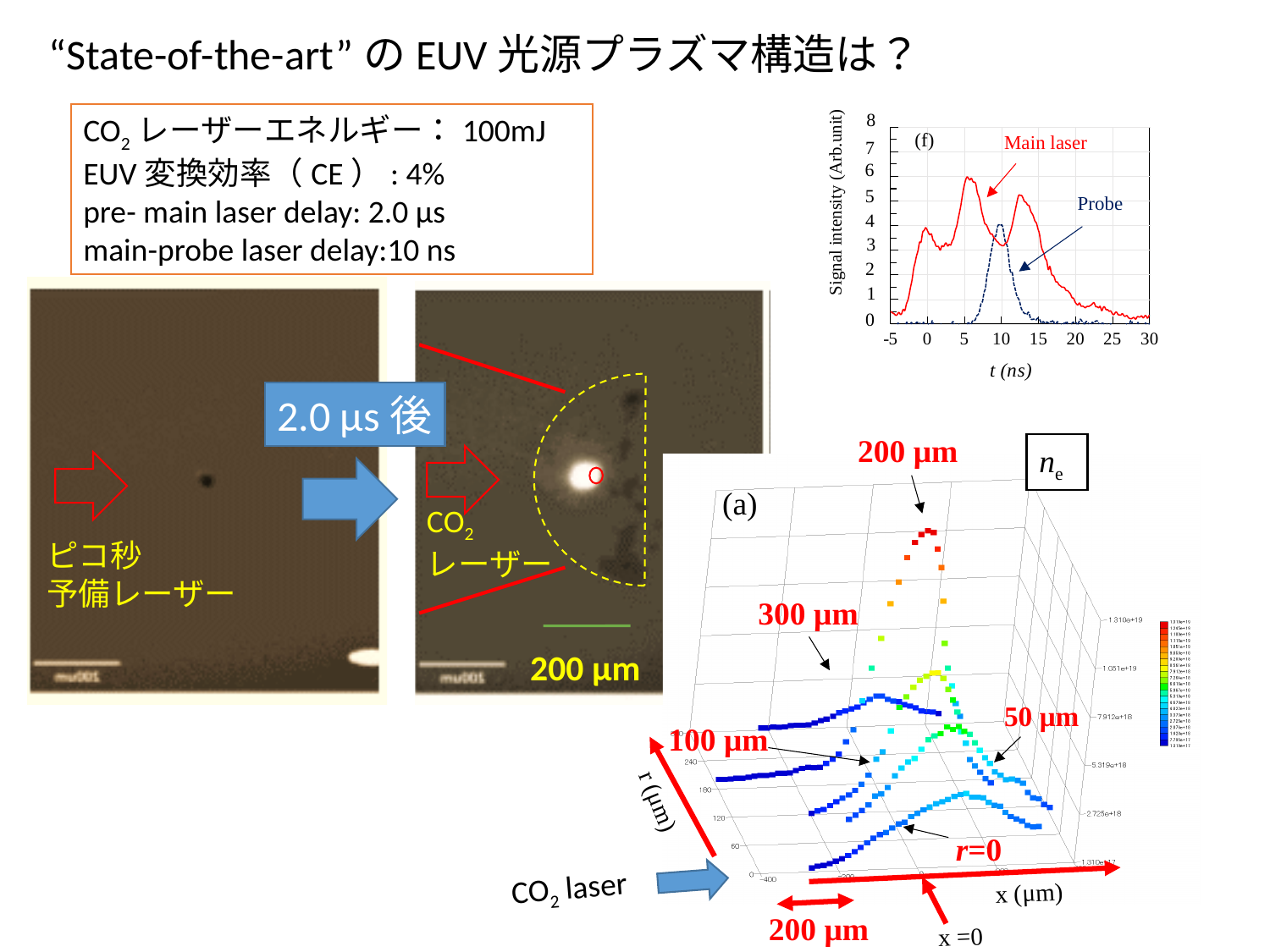
In the chart labelled (f) at the top right, what is the label of the x axis? t (ns) In the chart labelled (f) at the top right, is the peak value of the Probe signal greater or less than 5? less In the chart labelled (f) at the top right, what is the maximum value shown on the t (ns) axis? 30 In the chart labelled (f) at the top right, is the peak value of the Main laser signal greater or less than 5? greater In the 3D chart labelled (a) at the bottom right, what is the maximum value shown on the n_e colour scale? 1.310e+19 In the chart labelled (f) at the top right, is the peak value of the Probe signal greater or less than 3? greater In the chart labelled (f) at the top right, what kind of chart is it? line chart In the chart labelled (f) at the top right, what is the label of the y axis? Signal intensity (Arb.unit) In the 3D chart labelled (a) at the bottom right, how many r-position profiles are labelled (r=0, 50 μm, 100 μm, 200 μm, 300 μm)? 5 In the 3D chart labelled (a) at the bottom right, which labelled profile reaches the highest electron density n_e? 200 μm In the chart labelled (f) at the top right, how many series are plotted? 2 In the chart labelled (f) at the top right, which series reaches the higher peak signal intensity, Main laser or Probe? Main laser